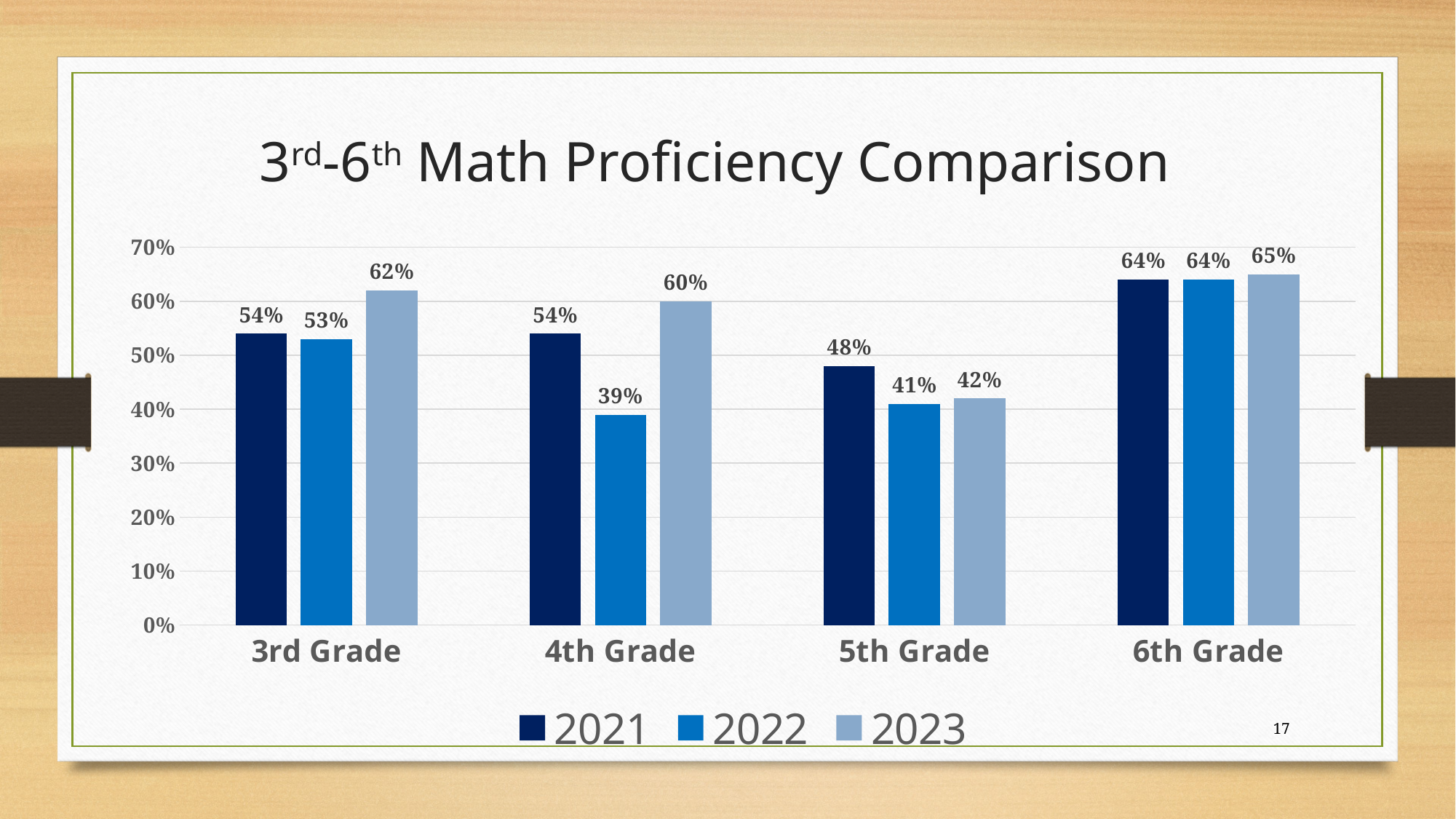
Which year does the darkest blue bar represent in the legend? 2021 What is the difference between the 2021 and 2022 values for 4th Grade? 15% What is the 2022 value for 5th Grade? 41% What is the 2023 math proficiency value for 4th Grade? 60% Which is larger for 5th Grade, the 2021 value or the 2023 value? 2021 What is the 2021 value for 3rd Grade? 54% How many series does the legend list? 3 How many grade categories are shown on the x axis? 4 What kind of chart is shown on the slide? bar chart Is the 2022 value for 4th Grade greater or less than 40%? less Which grade has the highest 2023 value? 6th Grade Which grade has the lowest 2022 value? 4th Grade